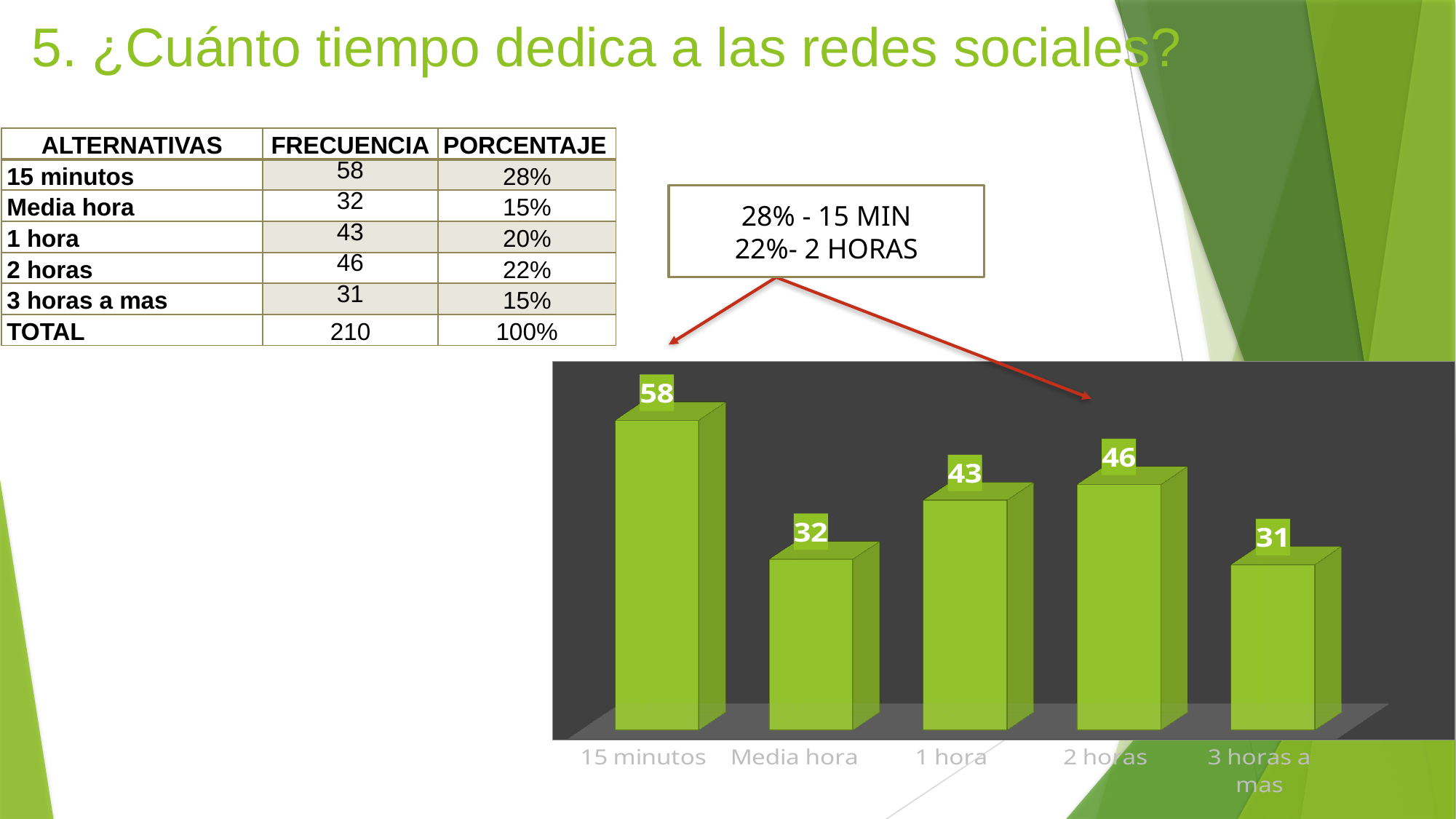
What kind of chart is shown on the slide? bar chart What is the difference between the values for 2 horas and 3 horas a mas? 15 What is the value for Media hora? 32 What is the value for 3 horas a mas? 31 Which category has the highest value? 15 minutos Which category has the lowest value? 3 horas a mas How many categories are shown in the chart? 5 What is the value for 2 horas? 46 What is the difference between the values for 15 minutos and Media hora? 26 What is the value for 1 hora? 43 What is the value for 15 minutos? 58 Which is larger, the value for 2 horas or the value for 1 hora? 2 horas